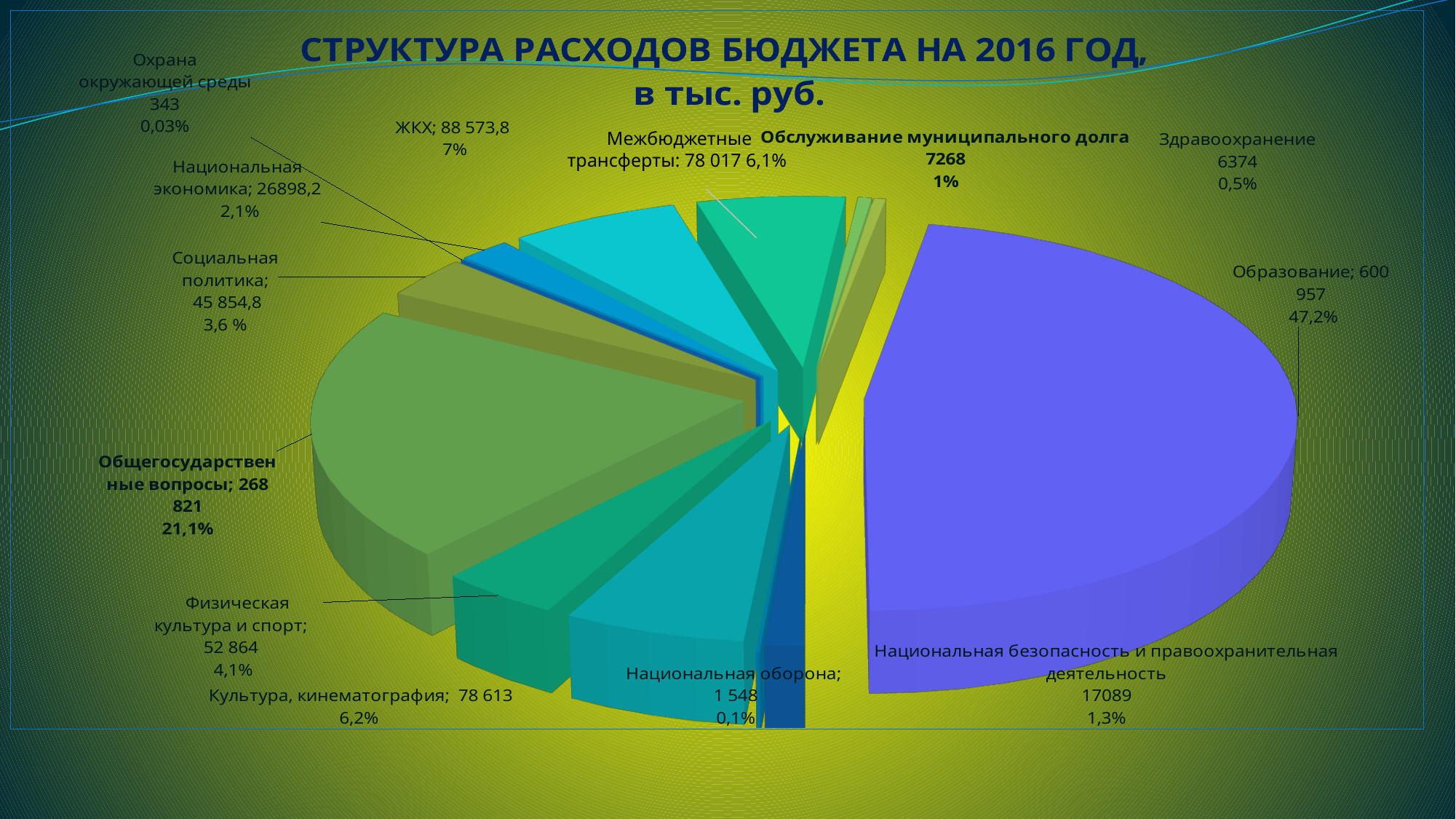
How many categories does the pie chart have? 13 Which category has the largest share of the pie? Образование What kind of chart is shown on the slide? pie chart Which is larger, the value for Культура, кинематография or the value for Физическая культура и спорт? Культура, кинематография What is the value for ЖКХ? 88 573,8 What is the value for Общегосударственные вопросы? 268 821 Which category has the smallest share of the pie? Охрана окружающей среды What is the title of the chart? СТРУКТУРА РАСХОДОВ БЮДЖЕТА НА 2016 ГОД, в тыс. руб. What share of the pie does Образование take? 47,2% What share of the pie does Физическая культура и спорт take? 4,1% What share of the pie does Общегосударственные вопросы take? 21,1% What is the value for Образование? 600 957